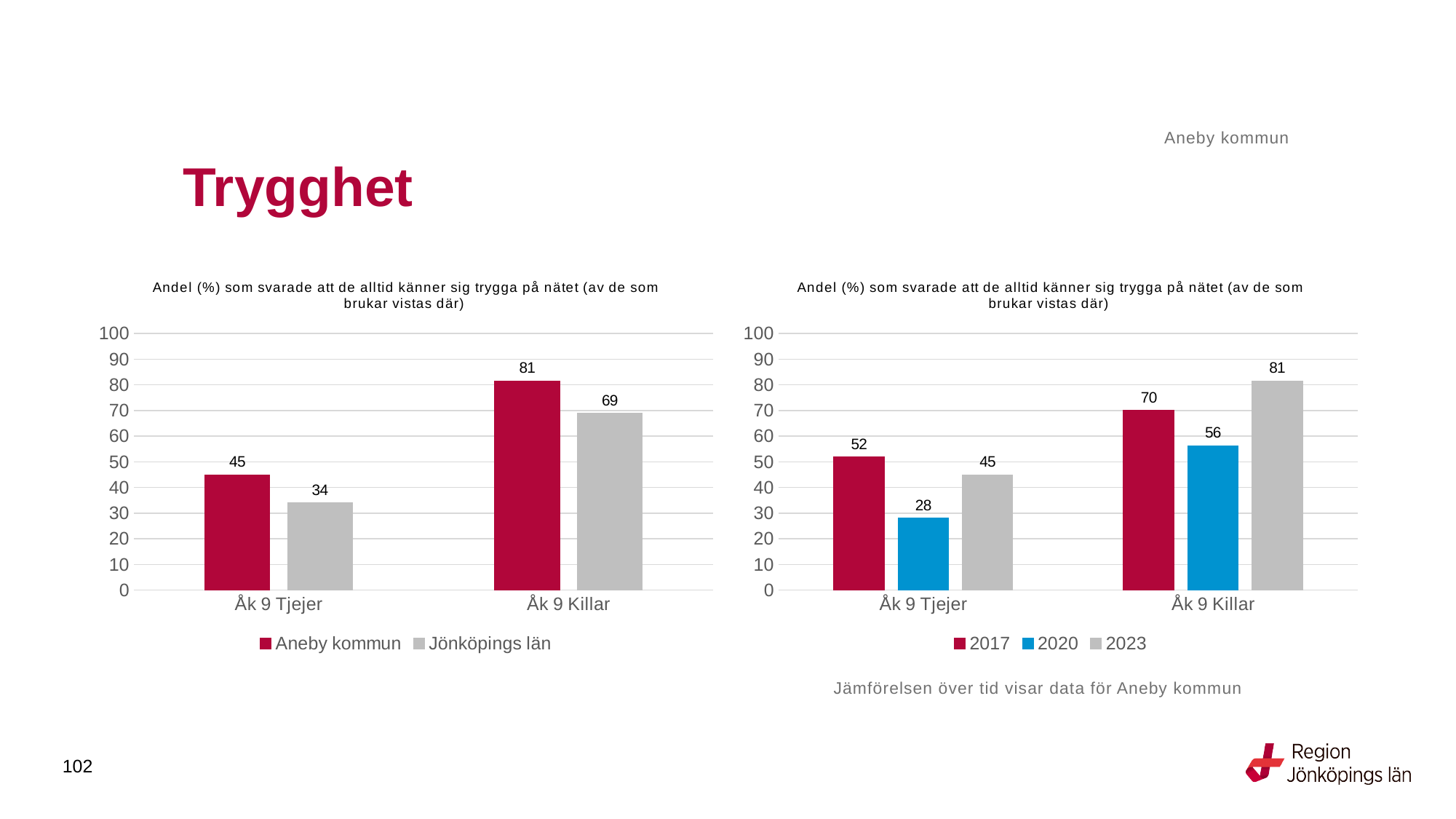
In the left chart, what is the value for Jönköpings län for Åk 9 Killar? 69 In the left chart, what is the difference between Aneby kommun and Jönköpings län for Åk 9 Killar? 12 In the right chart, which year has the lowest value for Åk 9 Killar? 2020 In the right chart, what is the difference between the 2017 and 2020 values for Åk 9 Tjejer? 24 How many series does the legend of the left chart list? 2 In the right chart, what is the value for 2023 for Åk 9 Killar? 81 In the left chart, which series has the higher value for Åk 9 Tjejer, Aneby kommun or Jönköpings län? Aneby kommun How many series does the legend of the right chart list? 3 In the left chart, what is the value for Aneby kommun for Åk 9 Tjejer? 45 In the right chart, what is the value for 2020 for Åk 9 Tjejer? 28 What kind of chart is the right chart? Bar chart In the right chart, which year has the highest value for Åk 9 Tjejer? 2017